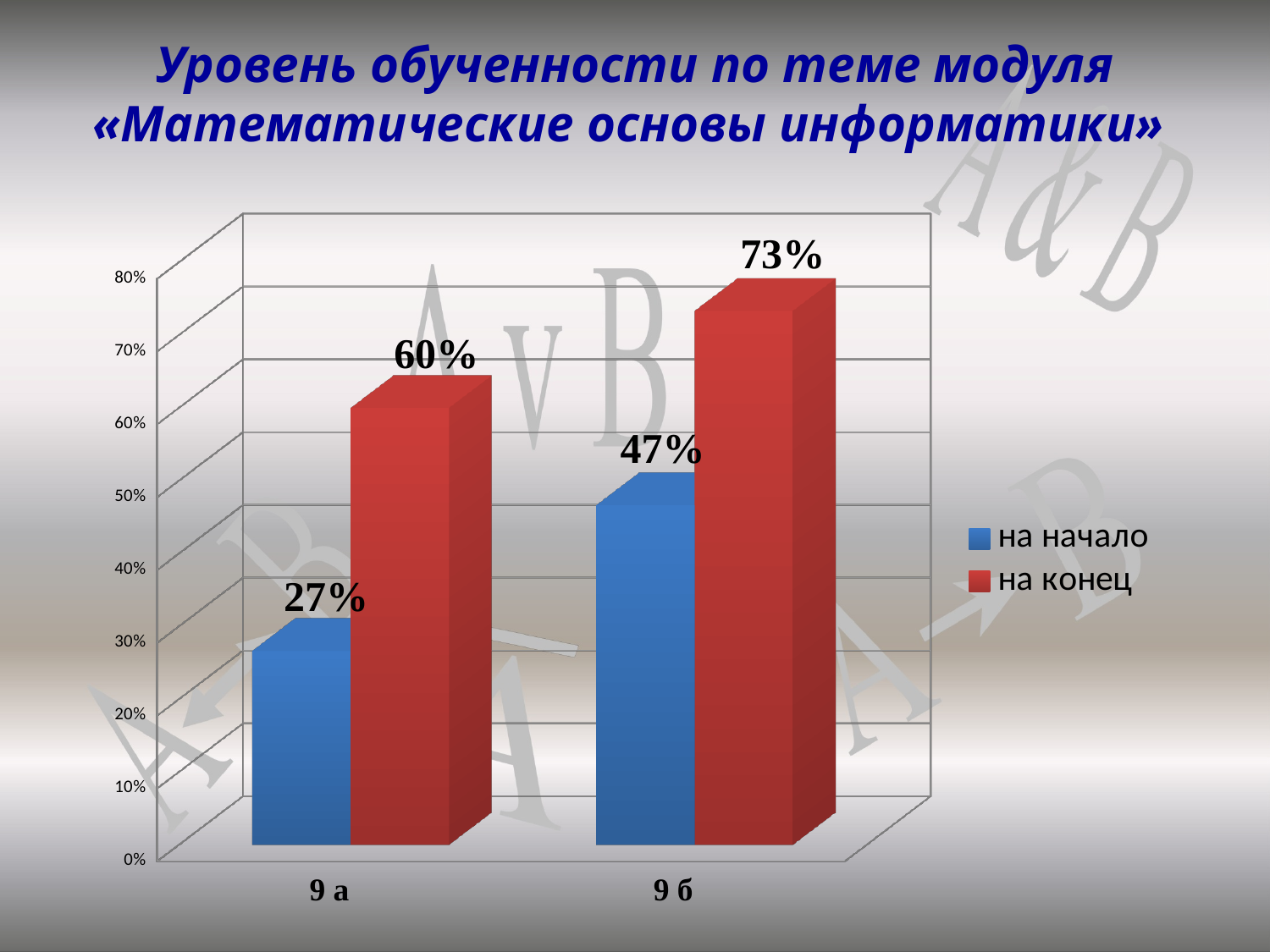
What is the value for "на начало" for 9 б? 47% What is the difference between the "на конец" and "на начало" values for 9 а? 33% Which category has the highest "на конец" value? 9 б What is the value for "на конец" for 9 а? 60% What is the value for "на начало" for 9 а? 27% Which is larger: the "на начало" value for 9 б or the "на конец" value for 9 а? на конец for 9 а Which category has the lowest "на начало" value? 9 а What is the value for "на конец" for 9 б? 73% How many series does the legend list? 2 What kind of chart is shown on the slide? bar chart How many categories are shown on the x axis? 2 What is the difference between the "на конец" values for 9 б and 9 а? 13%